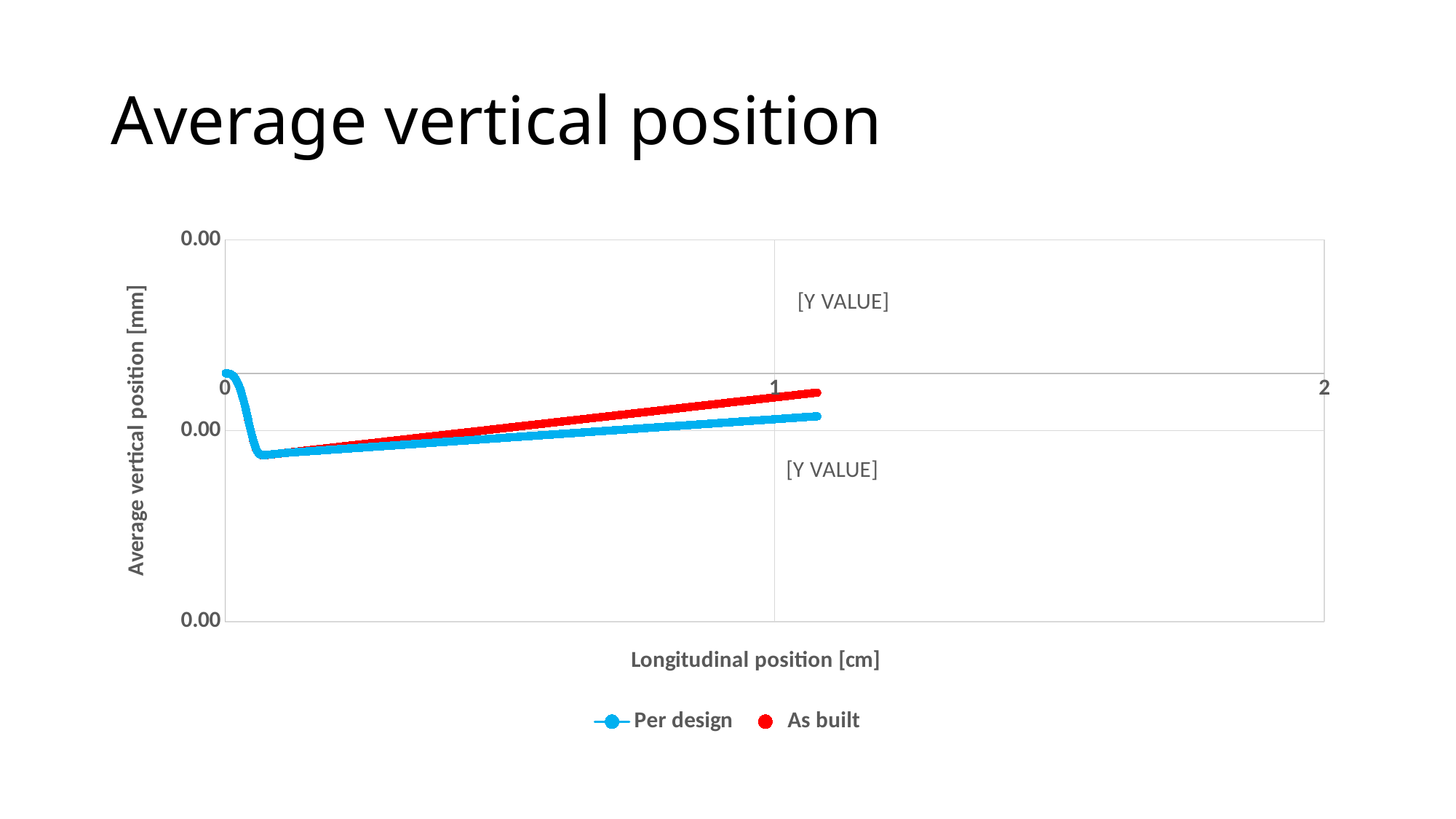
What are the names of the two series in the legend? Per design and As built Which series reaches the lower value at the end of the plotted range (around 1 cm)? Per design Which series is drawn in red? As built How many series does the legend list? 2 Which series is drawn in blue? Per design At a longitudinal position of 1 cm, which series has the higher average vertical position, Per design or As built? As built Do the As built values rise or fall as the longitudinal position increases toward 1 cm? Rise After the initial drop near the start, do the Per design values rise or fall as the longitudinal position increases toward 1 cm? Rise What kind of chart is shown on the slide? Line chart